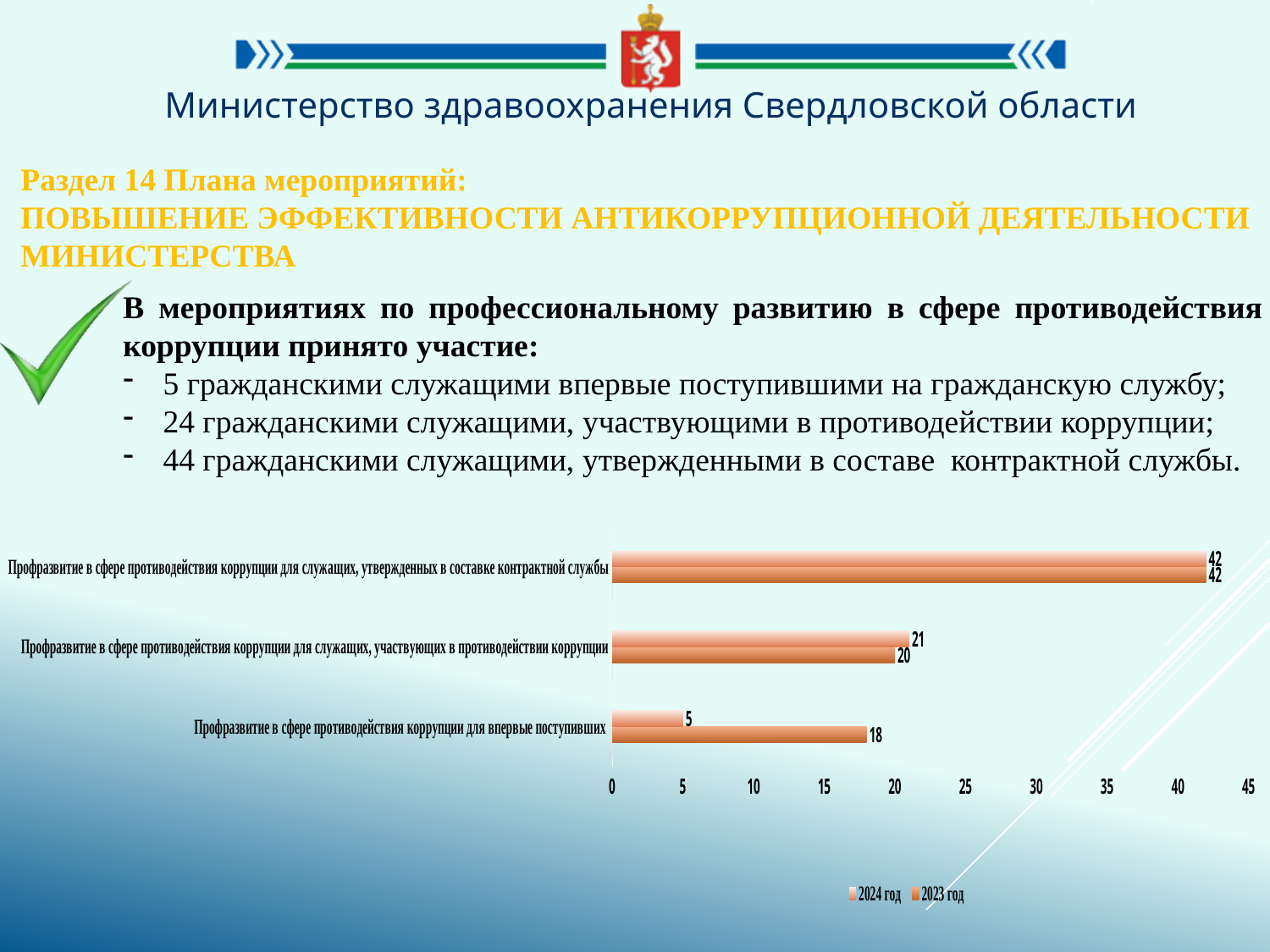
What are the two entries in the chart legend? 2024 год and 2023 год What values are labelled on the two bars for 'Профразвитие в сфере противодействия коррупции для служащих, участвующих в противодействии коррупции'? 21 and 20 What is the difference between the two bars for 'Профразвитие в сфере противодействия коррупции для впервые поступивших'? 13 What type of chart is shown on the slide? bar chart Which category has the highest values on the chart? Профразвитие в сфере противодействия коррупции для служащих, утвержденных в составке контрактной службы How many categories are plotted on the chart? 3 What values are labelled on the two bars for 'Профразвитие в сфере противодействия коррупции для служащих, утвержденных в составке контрактной службы'? 42 and 42 Are the values for 'Профразвитие в сфере противодействия коррупции для служащих, утвержденных в составке контрактной службы' greater or less than 40? greater For 'Профразвитие в сфере противодействия коррупции для впервые поступивших', which bar is longer, the upper or the lower one? the lower one How many series does the chart legend list? 2 What is the value labelled on the lower bar for 'Профразвитие в сфере противодействия коррупции для впервые поступивших'? 18 What is the value labelled on the upper bar for 'Профразвитие в сфере противодействия коррупции для впервые поступивших'? 5